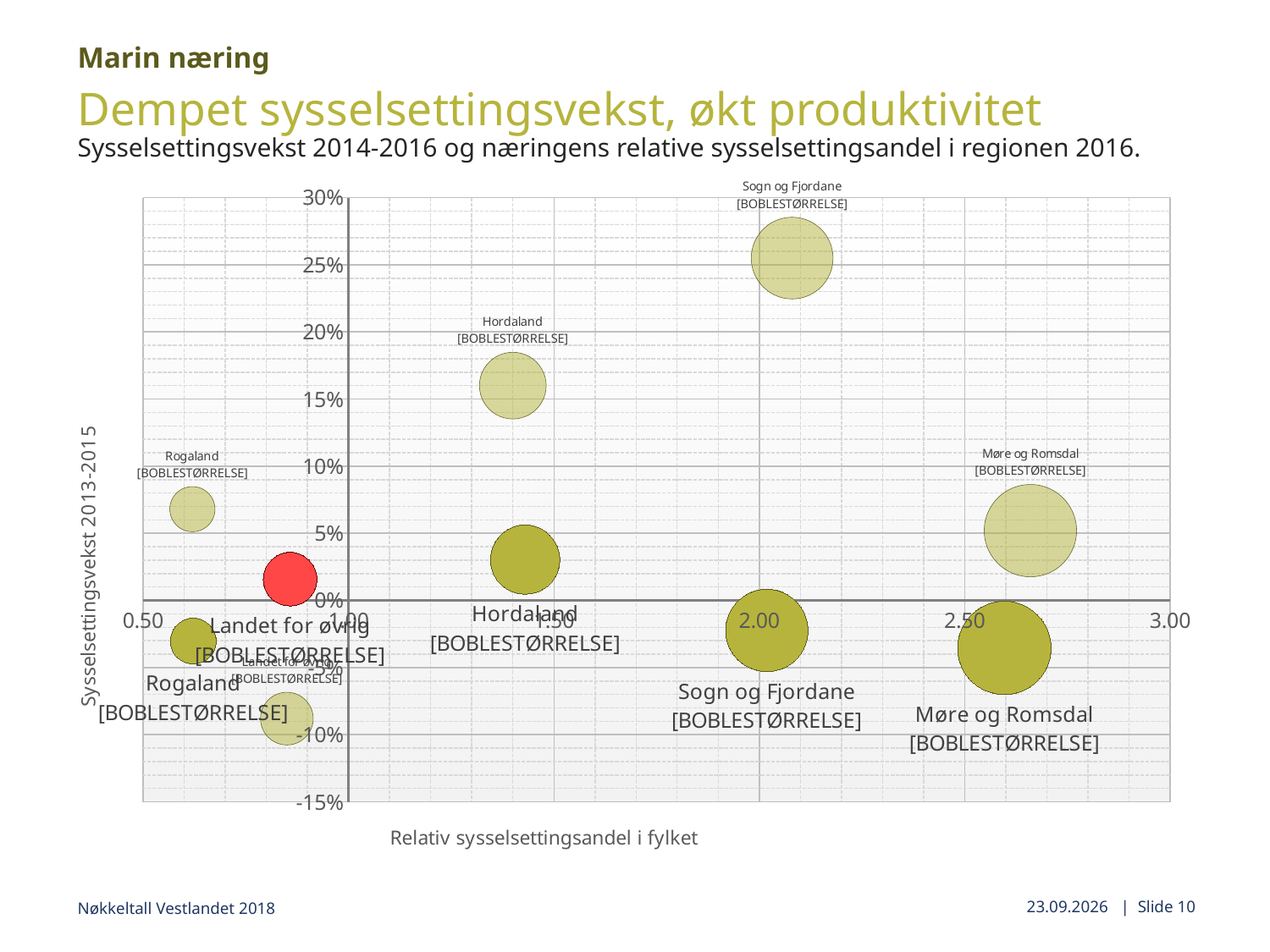
What kind of chart is shown on the slide? bubble chart Is the employment growth value for the light-coloured bubble labelled Hordaland greater or less than 10%? greater What is the title of the vertical axis of the chart? Sysselsettingsvekst 2013-2015 Which light-coloured bubble is positioned higher on the vertical axis, Sogn og Fjordane or Hordaland? Sogn og Fjordane Is the employment growth value for the light-coloured bubble labelled Hordaland greater or less than 20%? less Is the horizontal-axis value for the light-coloured bubble labelled Møre og Romsdal greater or less than 2.50? greater What is the title of the horizontal axis of the chart? Relativ sysselsettingsandel i fylket Among the light-coloured bubbles, which region has the highest employment growth? Sogn og Fjordane